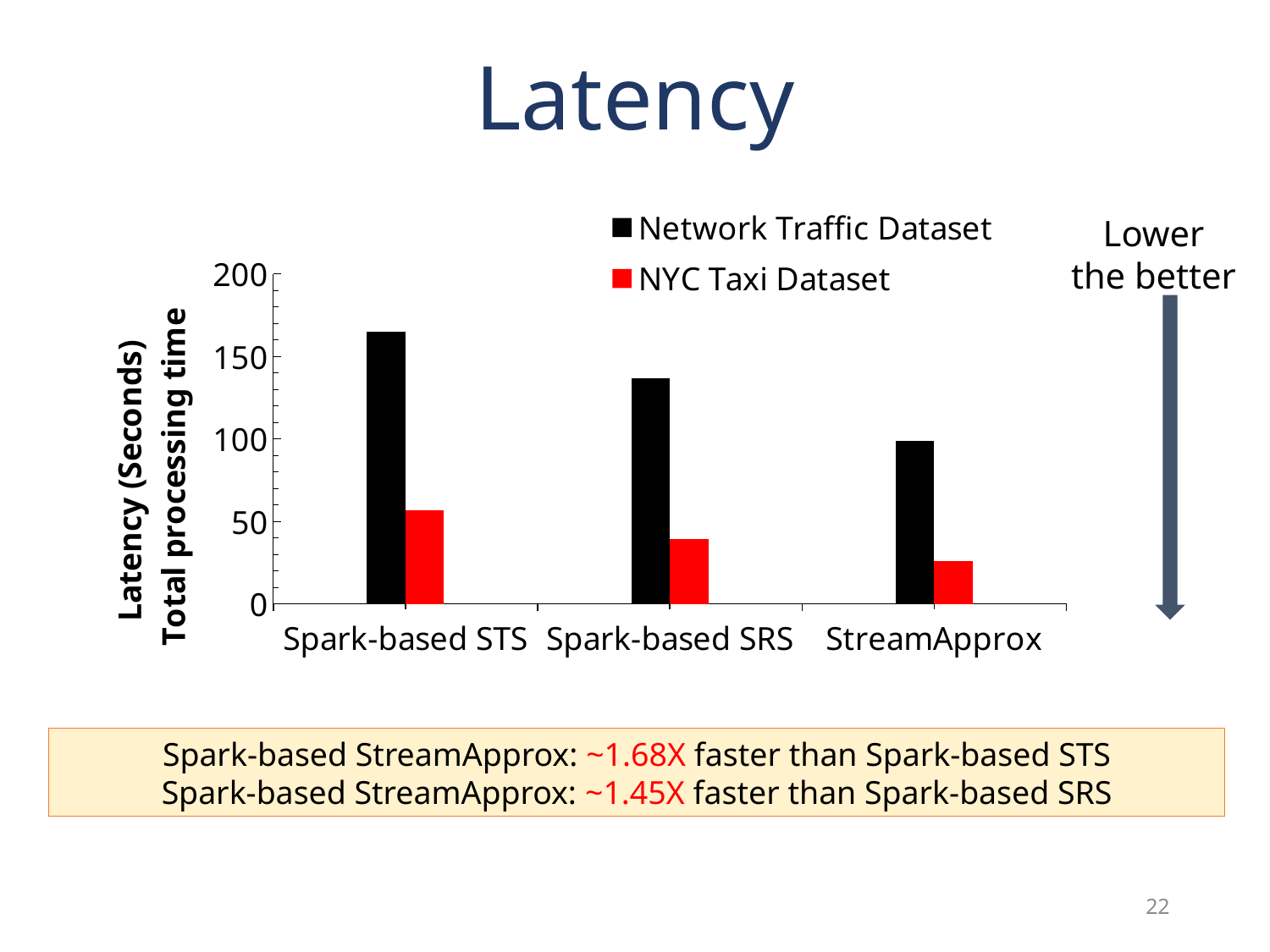
How many series does the legend list? 2 Which category has the lowest value for the Network Traffic Dataset? StreamApprox Which is larger for the Network Traffic Dataset: Spark-based STS or StreamApprox? Spark-based STS What kind of chart is shown on the slide? bar chart Which category has the highest value for the Network Traffic Dataset? Spark-based STS Is the NYC Taxi Dataset value for Spark-based SRS greater or less than 50? less How many categories are shown on the x axis? 3 Is the Network Traffic Dataset value for Spark-based SRS greater or less than 150? less Which category has the lowest value for the NYC Taxi Dataset? StreamApprox What colour represents the NYC Taxi Dataset in the legend? red Do the Network Traffic Dataset values rise or fall from Spark-based STS to StreamApprox along the x axis? fall Is the Network Traffic Dataset value for Spark-based STS greater or less than 150? greater